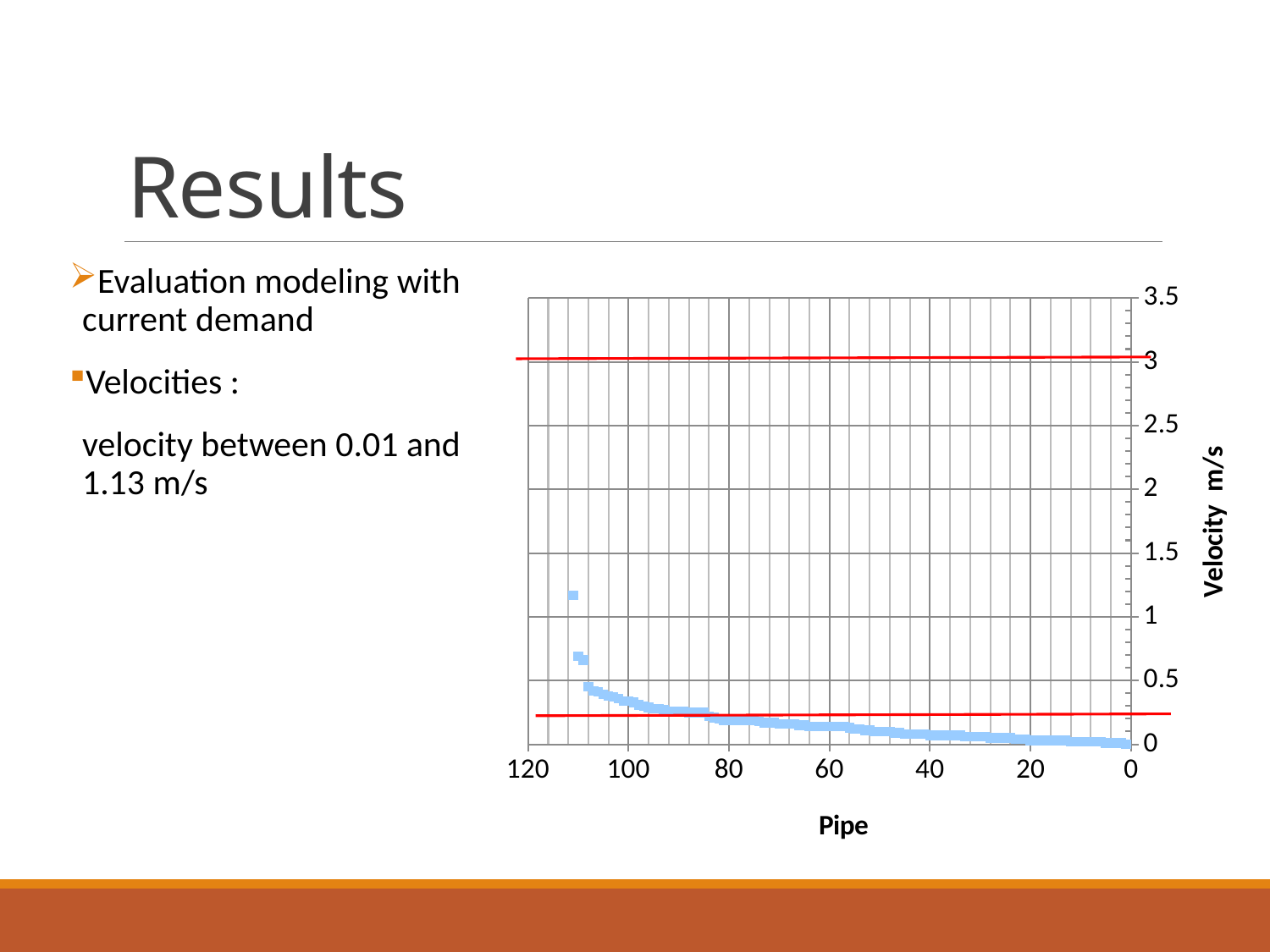
Are the plotted velocity values near pipe 20 greater or less than 0.5? less What is the title of the horizontal axis of the chart? Pipe Do the plotted velocity values rise or fall moving from left to right along the x axis? fall What is the maximum value shown on the vertical axis of the chart? 3.5 What is the title of the vertical axis of the chart? Velocity m/s Is the highest plotted velocity value greater or less than 3? less Are the plotted velocity values near pipe 60 greater or less than 0.5? less What kind of chart is shown on the slide? scatter chart